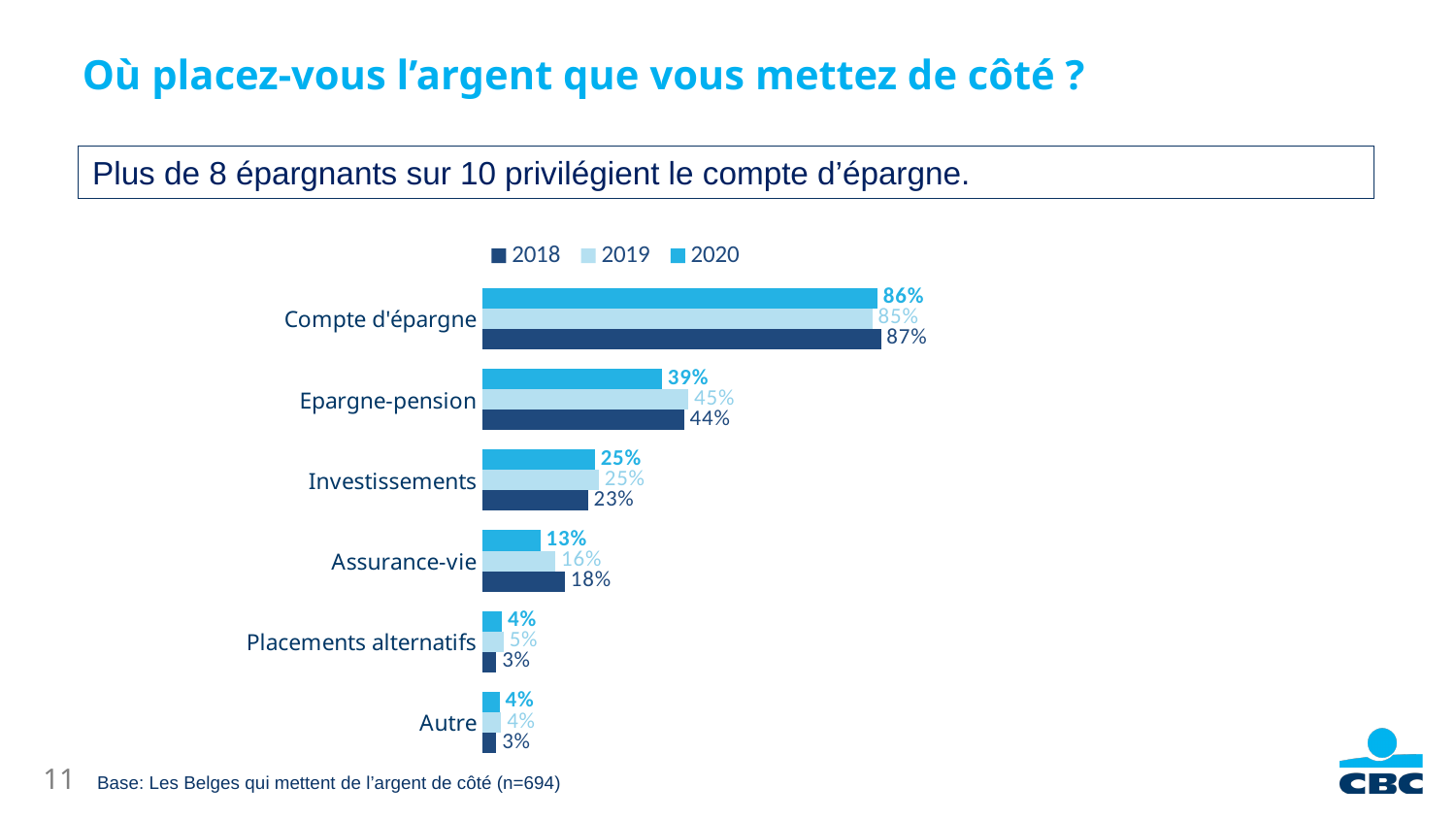
What is the value for Compte d'épargne in 2020? 86% How many categories are shown on the chart? 6 What kind of chart is shown on the slide? Bar chart Which category has the lowest value in 2018? Placements alternatifs and Autre (both 3%) What are the series listed in the legend? 2018, 2019, 2020 What is the value for Placements alternatifs in 2019? 5% What is the value for Epargne-pension in 2019? 45% Which is larger for Assurance-vie: the 2018 value or the 2020 value? 2018 Which category has the highest value in 2020? Compte d'épargne What is the value for Assurance-vie in 2018? 18% What is the difference between the 2019 and 2020 values for Epargne-pension? 6 percentage points How many series does the legend list? 3